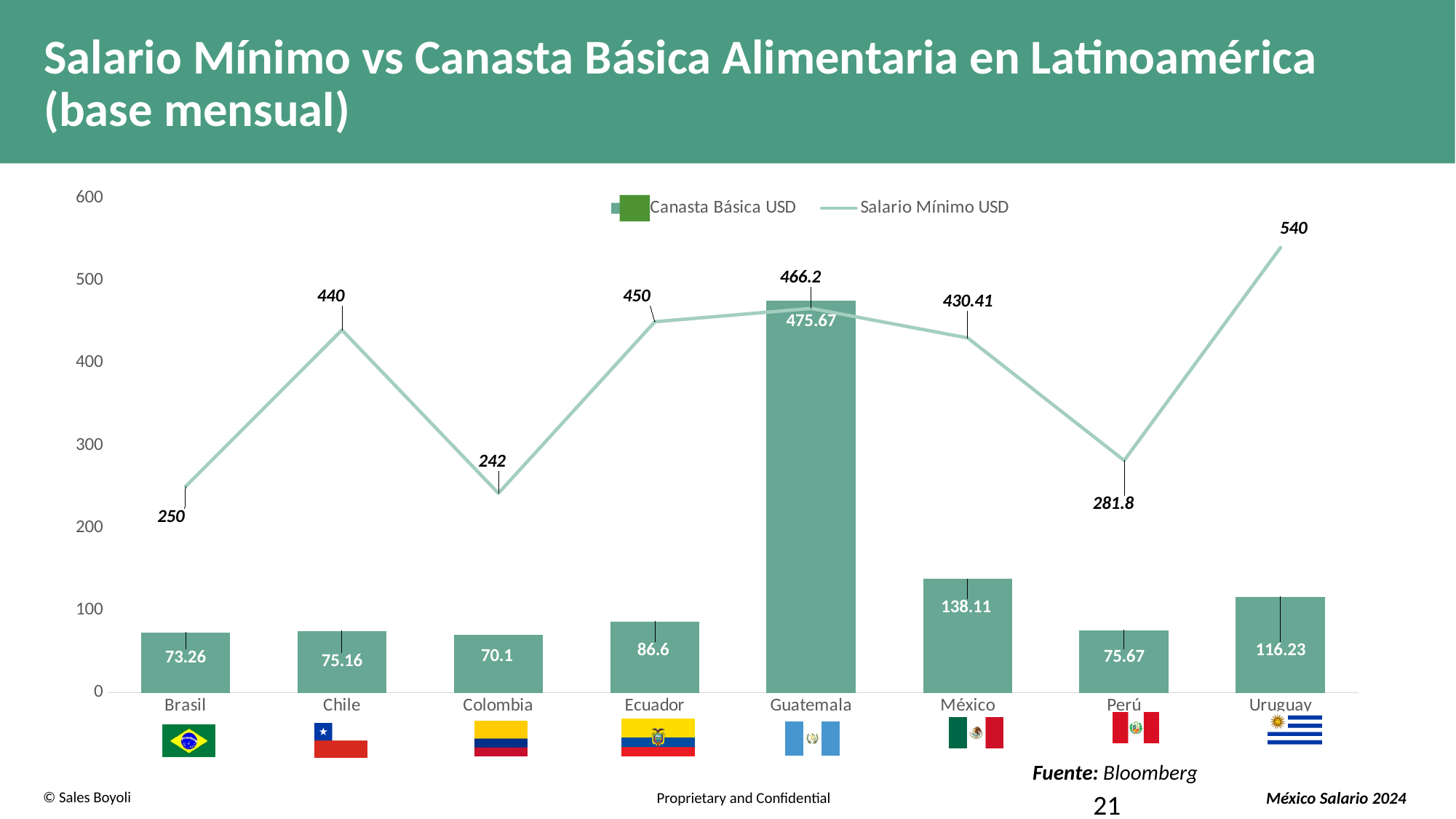
How many series does the legend list? 2 Is the Salario Mínimo USD for Perú greater or less than 300? less What kind of chart is this? Combined bar and line chart Which is larger, the Canasta Básica USD for Uruguay or for México? México Which country has the lowest Salario Mínimo USD? Colombia How many countries are shown on the x axis? 8 Which country has the highest Salario Mínimo USD? Uruguay What is the Canasta Básica USD value for México? 138.11 What is the Canasta Básica USD value for Guatemala? 475.67 What is the difference between the Salario Mínimo USD for Chile and for Brasil? 190 Which country has the lowest Canasta Básica USD? Colombia What is the Salario Mínimo USD value for Uruguay? 540